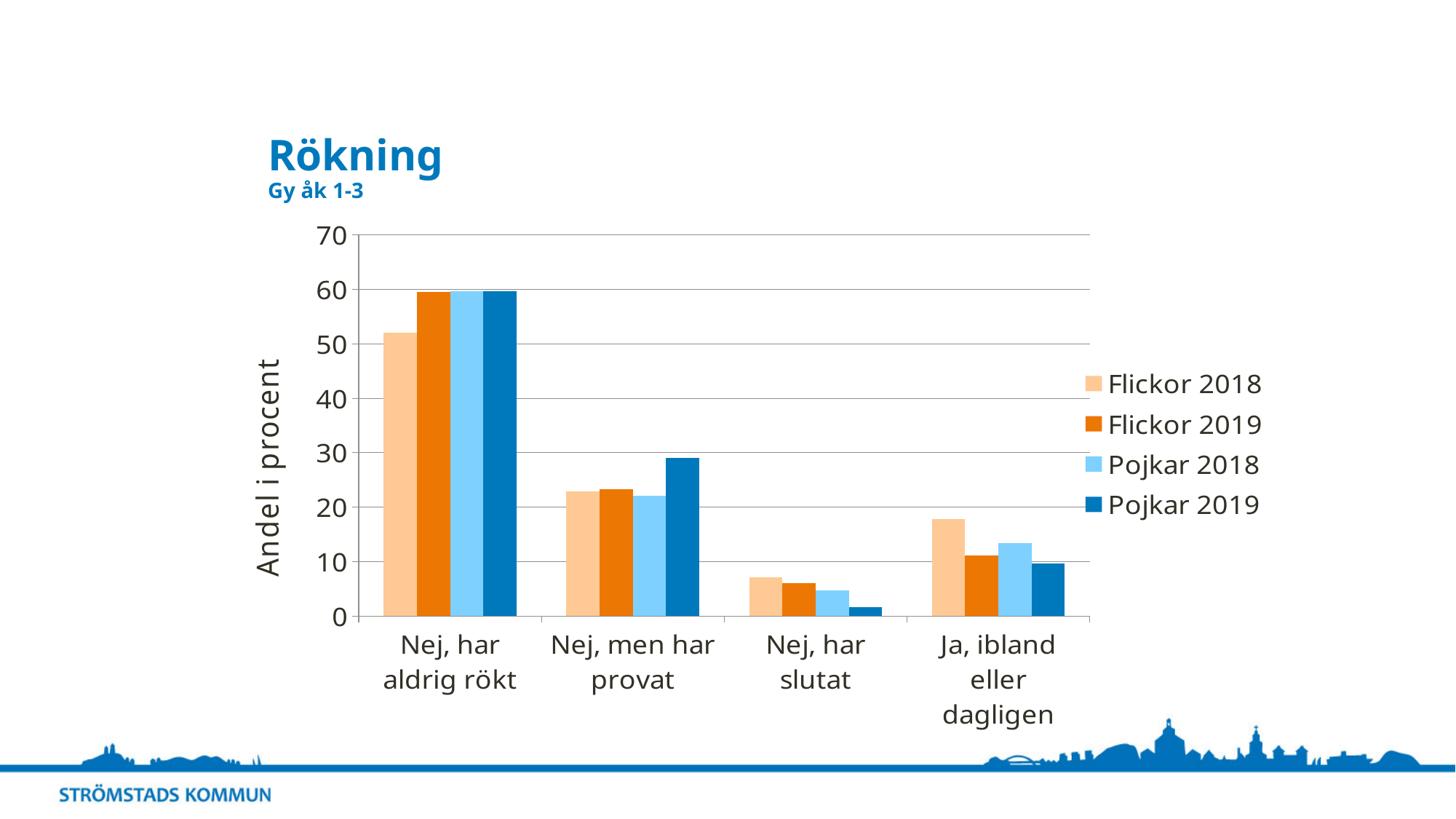
How many series does the legend list? 4 Is the value for Pojkar 2019 in the category "Nej, men har provat" greater or less than 20? greater In the category "Nej, men har provat", which is larger: Pojkar 2018 or Pojkar 2019? Pojkar 2019 Is the value for Flickor 2018 in the category "Ja, ibland eller dagligen" greater or less than 20? less How many categories are shown on the x axis? 4 Is the value for Flickor 2018 in the category "Nej, har aldrig rökt" greater or less than 60? less What is the label of the vertical axis? Andel i procent Which series has the highest value in the category "Ja, ibland eller dagligen"? Flickor 2018 In which category does Pojkar 2019 have its highest value? Nej, har aldrig rökt What kind of chart is shown on the slide? bar chart Which series has the lowest value in the category "Nej, har slutat"? Pojkar 2019